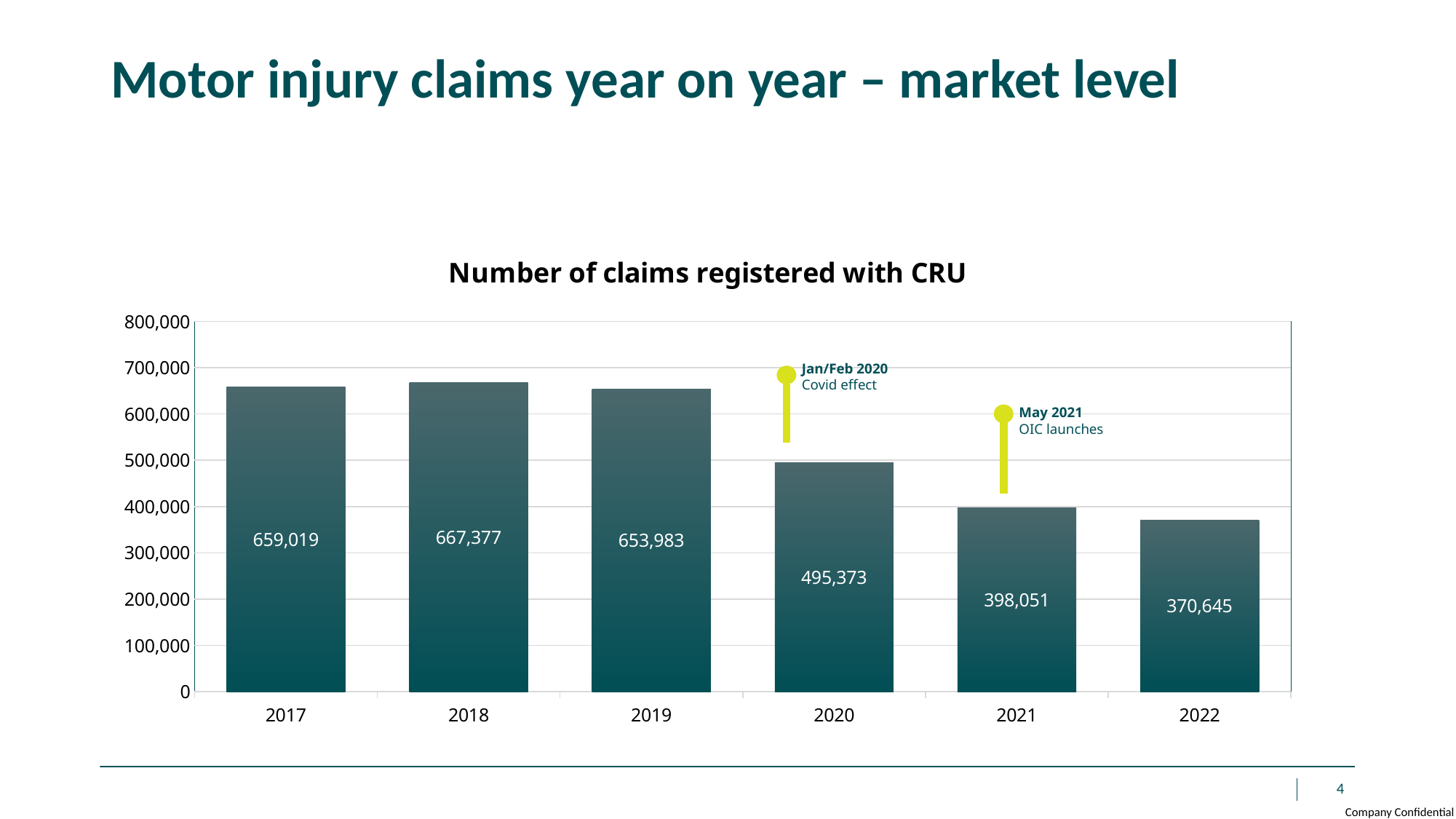
What kind of chart is shown on the slide? bar chart What is the difference between the number of claims in 2019 and in 2020? 158,610 What is the number of claims registered with CRU in 2022? 370,645 What is the number of claims registered with CRU in 2017? 659,019 Which year had more claims registered with CRU, 2017 or 2019? 2017 How many years are shown on the x axis of the chart? 6 What is the number of claims registered with CRU in 2020? 495,373 Which year has the highest number of claims registered with CRU? 2018 Is the value for 2021 greater or less than 500,000? less Which year has the lowest number of claims registered with CRU? 2022 What is the difference between the number of claims in 2021 and in 2022? 27,406 What is the title of the chart? Number of claims registered with CRU